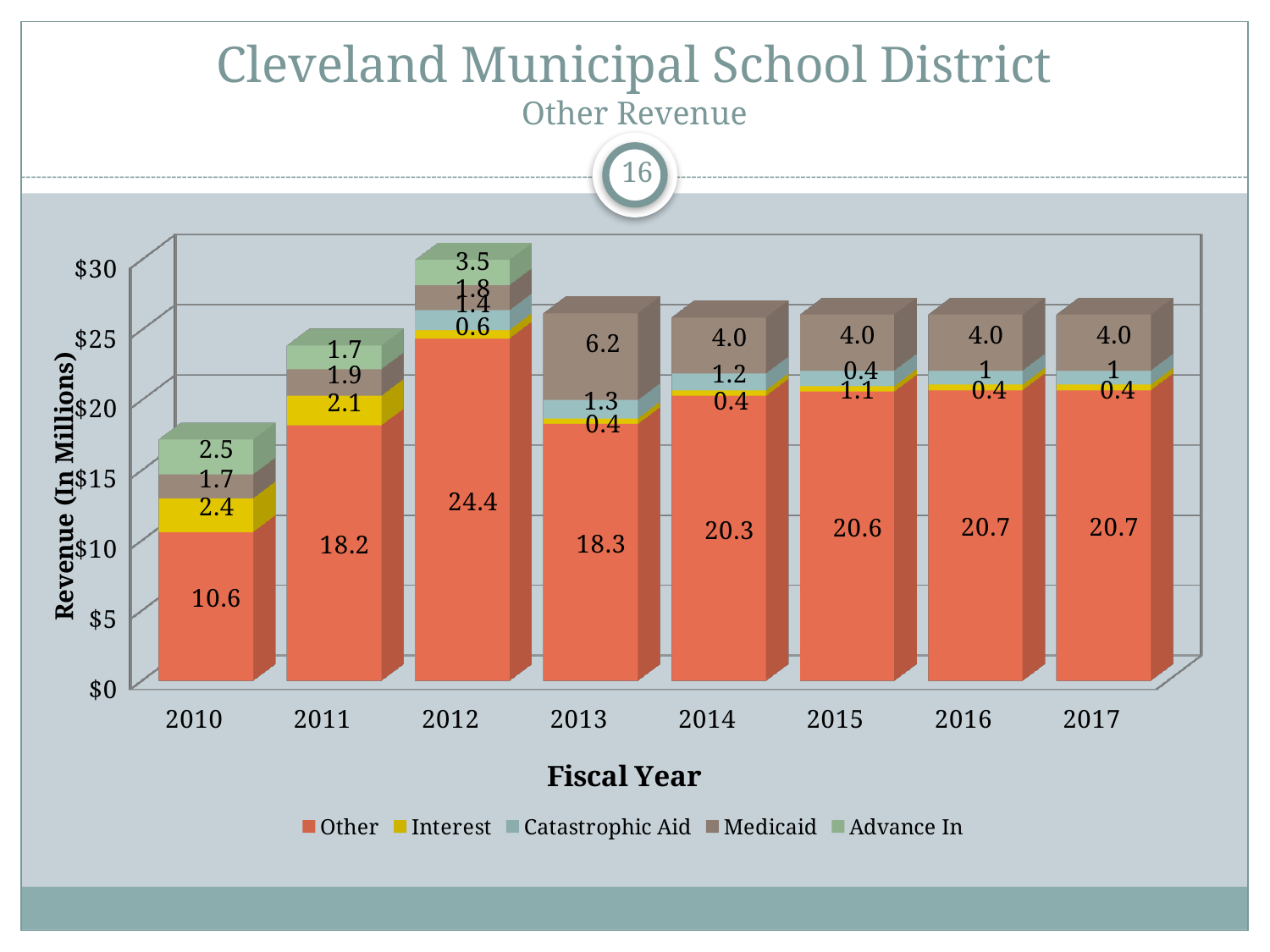
Which fiscal year has the larger Interest value, 2010 or 2011? 2010 What is the Advance In value for fiscal year 2010? 2.5 What is the Medicaid value for fiscal year 2013? 6.2 What kind of chart is shown on the slide? Stacked bar chart Which fiscal year has the highest Medicaid value? 2013 What is the title of the y axis? Revenue (In Millions) What is the value of the Other segment for fiscal year 2012? 24.4 What is the difference between the Other value in 2011 and the Other value in 2010? 7.6 How many fiscal years are shown on the x axis? 8 Which fiscal year has the lowest Other value? 2010 What is the Advance In value for fiscal year 2012? 3.5 How many series does the legend list? 5